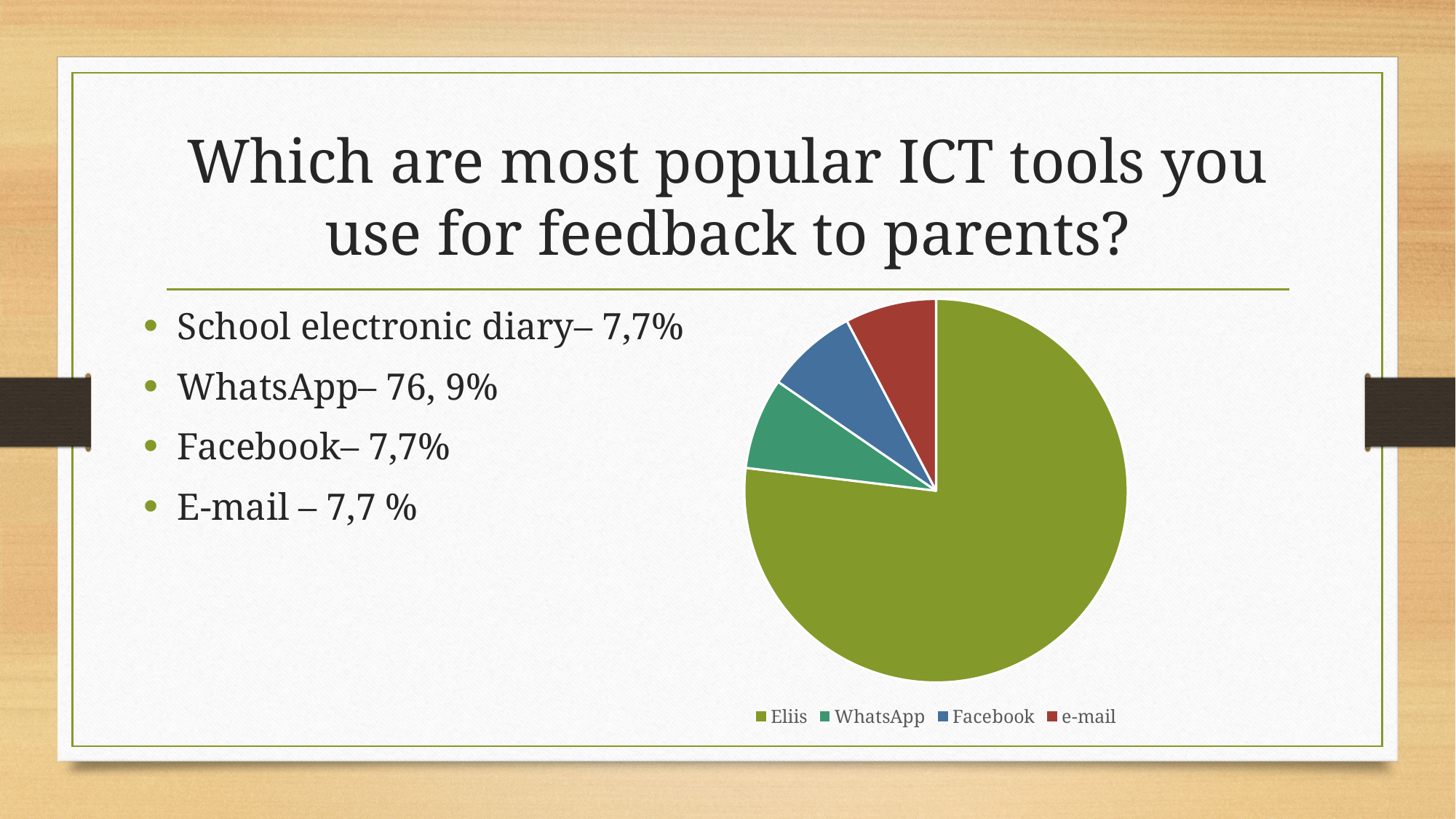
Which slice is larger in the pie chart, Eliis or WhatsApp? Eliis Which category has the largest slice in the pie chart? Eliis What kind of chart is shown on the slide? pie chart Which slice is larger in the pie chart, Facebook or Eliis? Eliis How many slices does the pie chart have? 4 Which slice is larger in the pie chart, Eliis or e-mail? Eliis How many entries does the pie chart's legend list? 4 What colour is the Eliis slice in the pie chart? green Which legend entry is shown in red in the pie chart? e-mail Does the Eliis slice take up more or less than half of the pie chart? more